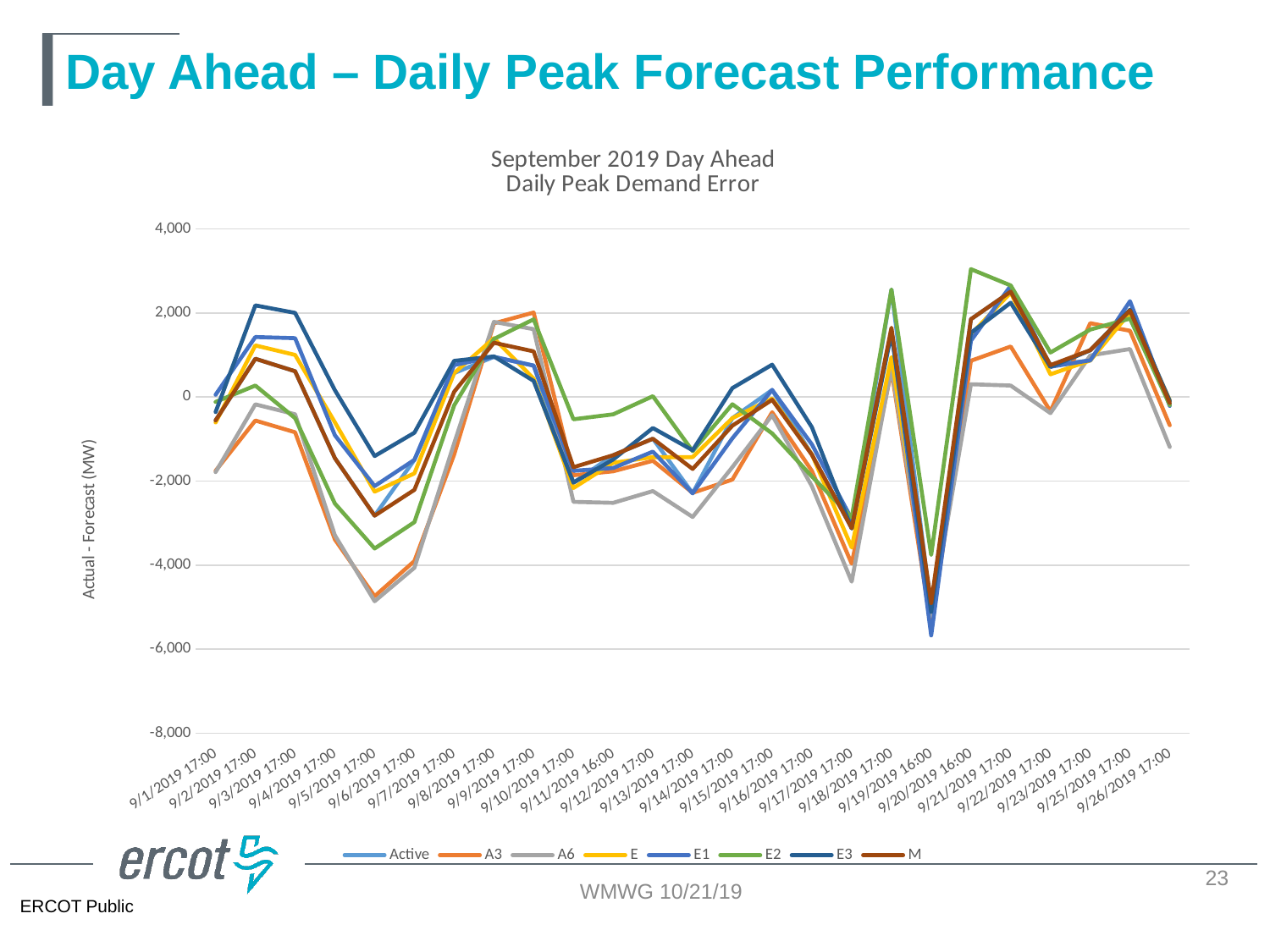
At 9/5/2019 17:00, which is larger, the value for E3 or the value for A6? E3 Which series has the lowest value at 9/19/2019 16:00? E1 Is the value for A6 at 9/5/2019 17:00 greater or less than -4,000? less Is the value for E3 at 9/2/2019 17:00 greater or less than 2,000? greater What kind of chart is shown on the slide? line chart How many series does the legend list? 8 Is the value for E2 at 9/20/2019 16:00 greater or less than 2,000? greater How many dates are shown along the x axis? 25 What is the title of the chart? September 2019 Day Ahead Daily Peak Demand Error What is the label on the vertical axis? Actual - Forecast (MW)